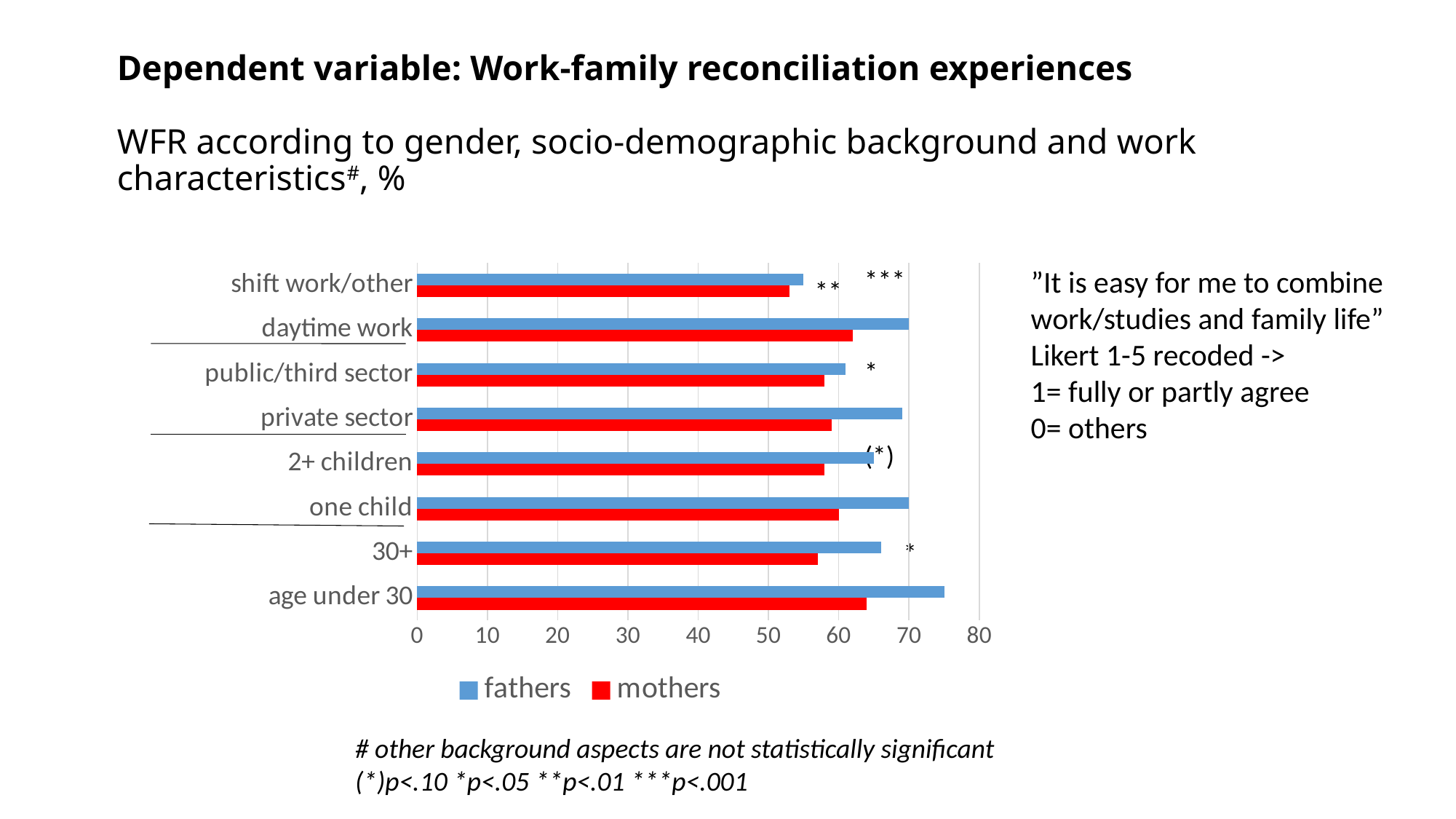
Is the value for fathers in the 'age under 30' category greater or less than 70? greater For the 'daytime work' category, which is larger: the value for fathers or for mothers? fathers What colour represents mothers in the chart? red Which category has the highest value for fathers? age under 30 Is the value for fathers in the 'private sector' category greater or less than 60? greater What kind of chart is shown on the slide? bar chart How many categories are shown on the chart's vertical axis? 8 For fathers, which is larger: the value for 'daytime work' or for 'shift work/other'? daytime work Which category has the lowest value for fathers? shift work/other Is the value for mothers in the '30+' category greater or less than 60? less How many series does the chart's legend list? 2